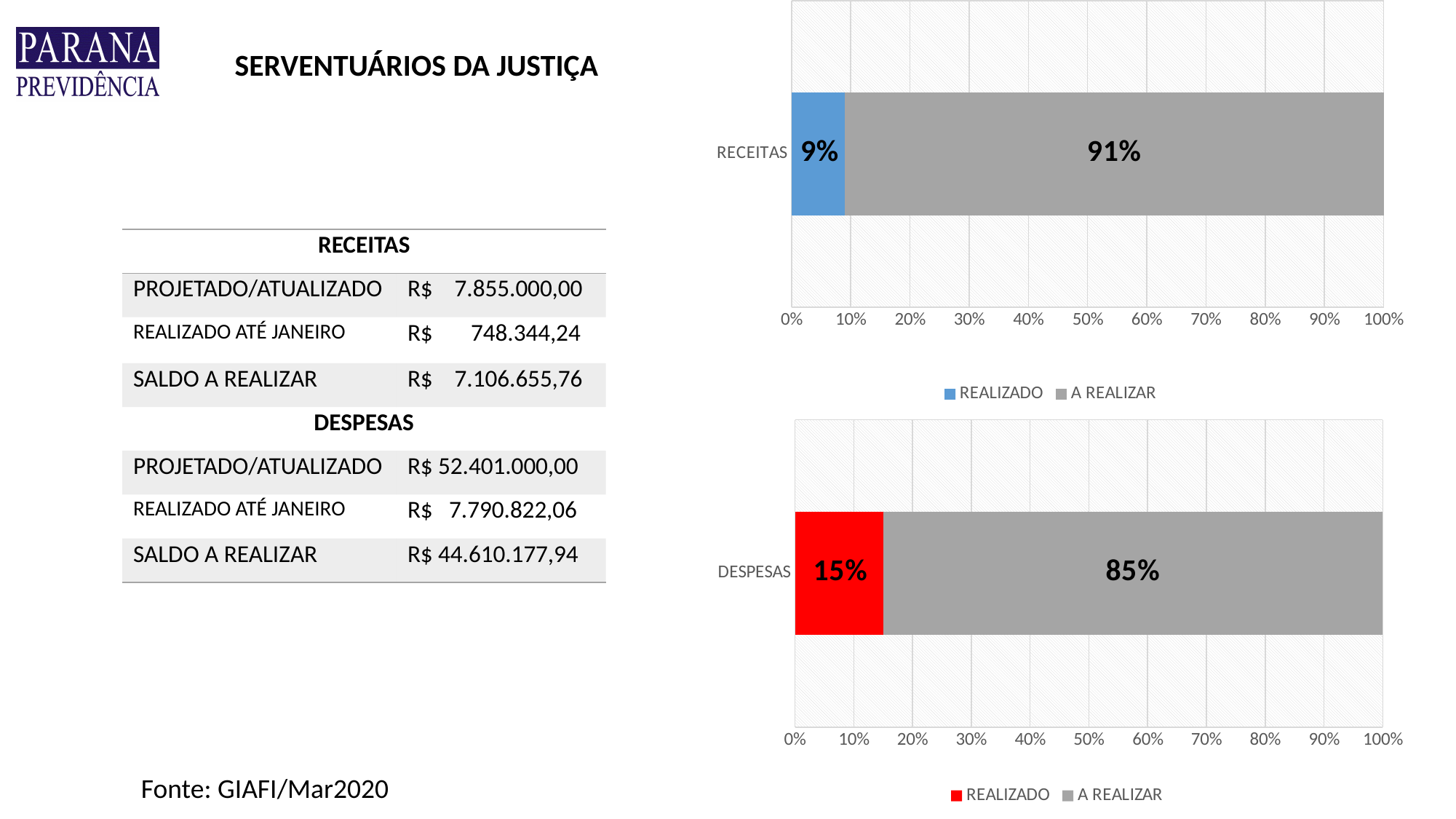
In the DESPESAS chart (bottom right), which series is larger, REALIZADO or A REALIZAR? A REALIZAR How many series does the legend of the DESPESAS chart (bottom right) list? 2 In the RECEITAS chart (top right), what is the difference between A REALIZAR and REALIZADO? 82% In the DESPESAS chart (bottom right), what is the value for A REALIZAR? 85% In the DESPESAS chart (bottom right), what colour is the REALIZADO segment? Red In the RECEITAS chart (top right), is the value for REALIZADO greater or less than 10%? less What kind of chart is the RECEITAS chart (top right)? Stacked bar chart In the RECEITAS chart (top right), what is the total of the stacked bar? 100% In the RECEITAS chart (top right), what is the value for A REALIZAR? 91% In the RECEITAS chart (top right), what is the value for REALIZADO? 9% In the DESPESAS chart (bottom right), what is the value for REALIZADO? 15% In the DESPESAS chart (bottom right), what is the difference between A REALIZAR and REALIZADO? 70%